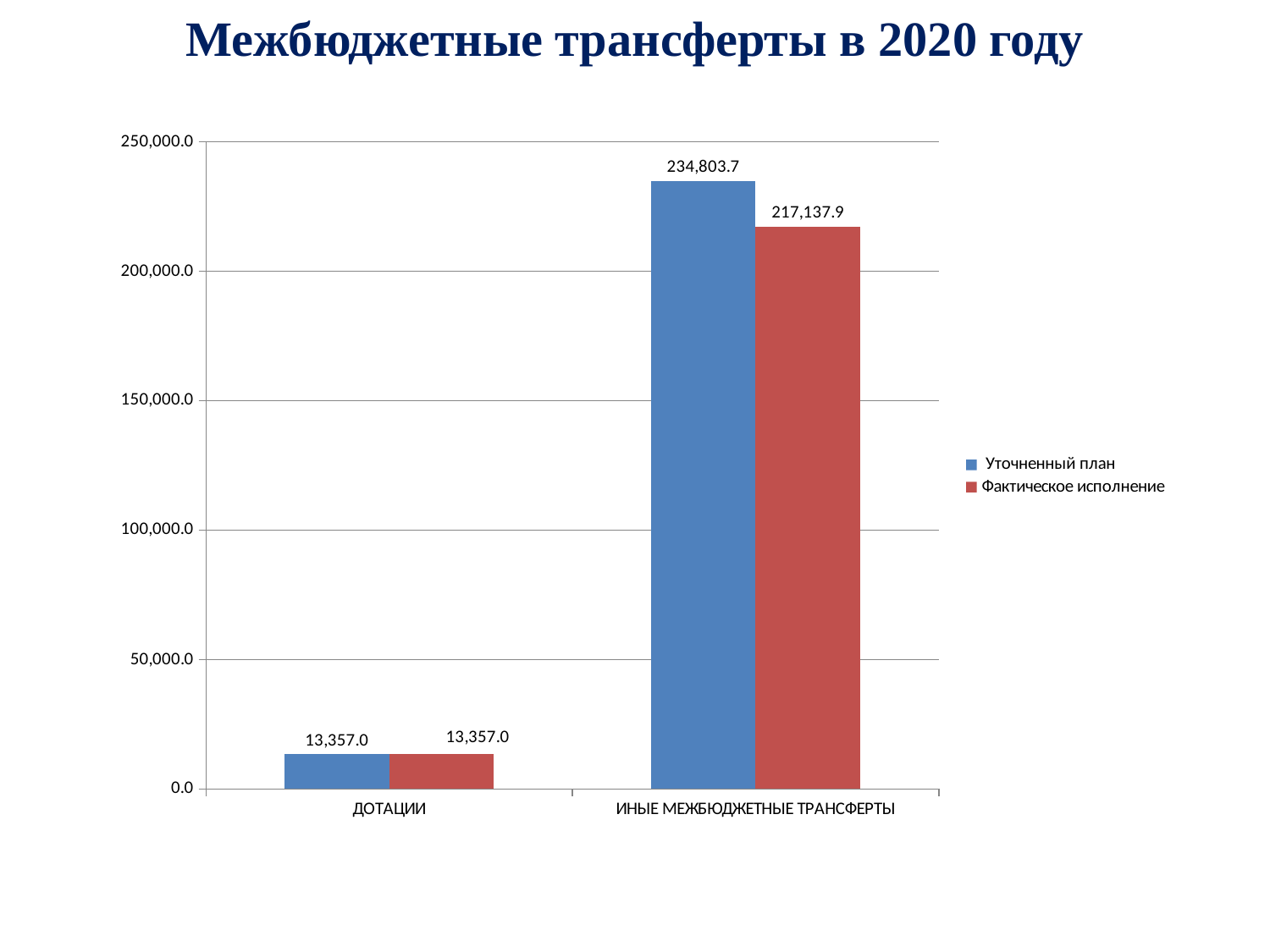
Which category has the highest value for Уточненный план? ИНЫЕ МЕЖБЮДЖЕТНЫЕ ТРАНСФЕРТЫ What is the value of Фактическое исполнение for ИНЫЕ МЕЖБЮДЖЕТНЫЕ ТРАНСФЕРТЫ? 217,137.9 For ИНЫЕ МЕЖБЮДЖЕТНЫЕ ТРАНСФЕРТЫ, which is larger: Уточненный план or Фактическое исполнение? Уточненный план What is the difference between Уточненный план and Фактическое исполнение for ИНЫЕ МЕЖБЮДЖЕТНЫЕ ТРАНСФЕРТЫ? 17,665.8 Which category has the lowest value for Фактическое исполнение? ДОТАЦИИ What type of chart is shown on the slide? bar chart What is the title of the chart? Межбюджетные трансферты в 2020 году What is the value of Уточненный план for ДОТАЦИИ? 13,357.0 What is the value of Уточненный план for ИНЫЕ МЕЖБЮДЖЕТНЫЕ ТРАНСФЕРТЫ? 234,803.7 How many series does the legend list? 2 What is the value of Фактическое исполнение for ДОТАЦИИ? 13,357.0 How many categories are shown on the x axis? 2